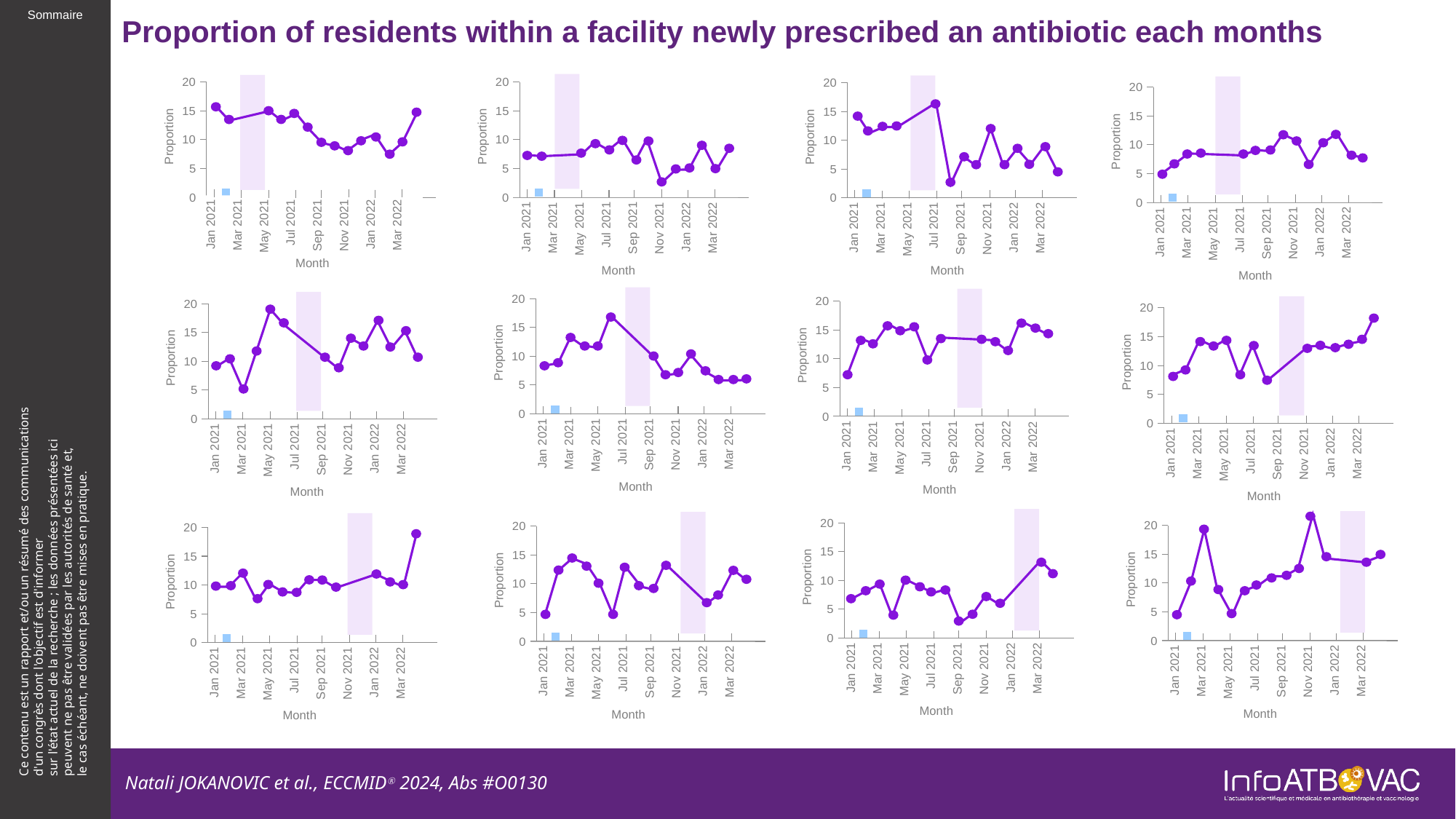
What is the label of the y axis on the charts? Proportion In the third chart of the bottom row, which month has the lowest proportion? Sep 2021 What kind of chart is used in each of the panels on the slide? Line chart In the second chart of the middle row, does the proportion rise or fall from Jun 2021 to Sep 2021? fall In the first chart of the bottom row, which month has the highest proportion? Apr 2022 In the fourth chart of the bottom row, is the value for Nov 2021 greater or less than 20? greater In the first chart of the middle row, is the value for May 2021 greater or less than 15? greater How many charts are shown on the slide? 12 In the second chart of the top row, is the value for Nov 2021 greater or less than 5? less In the first chart of the middle row, which month has the highest proportion? May 2021 In the third chart of the top row, which month has the highest proportion? Jul 2021